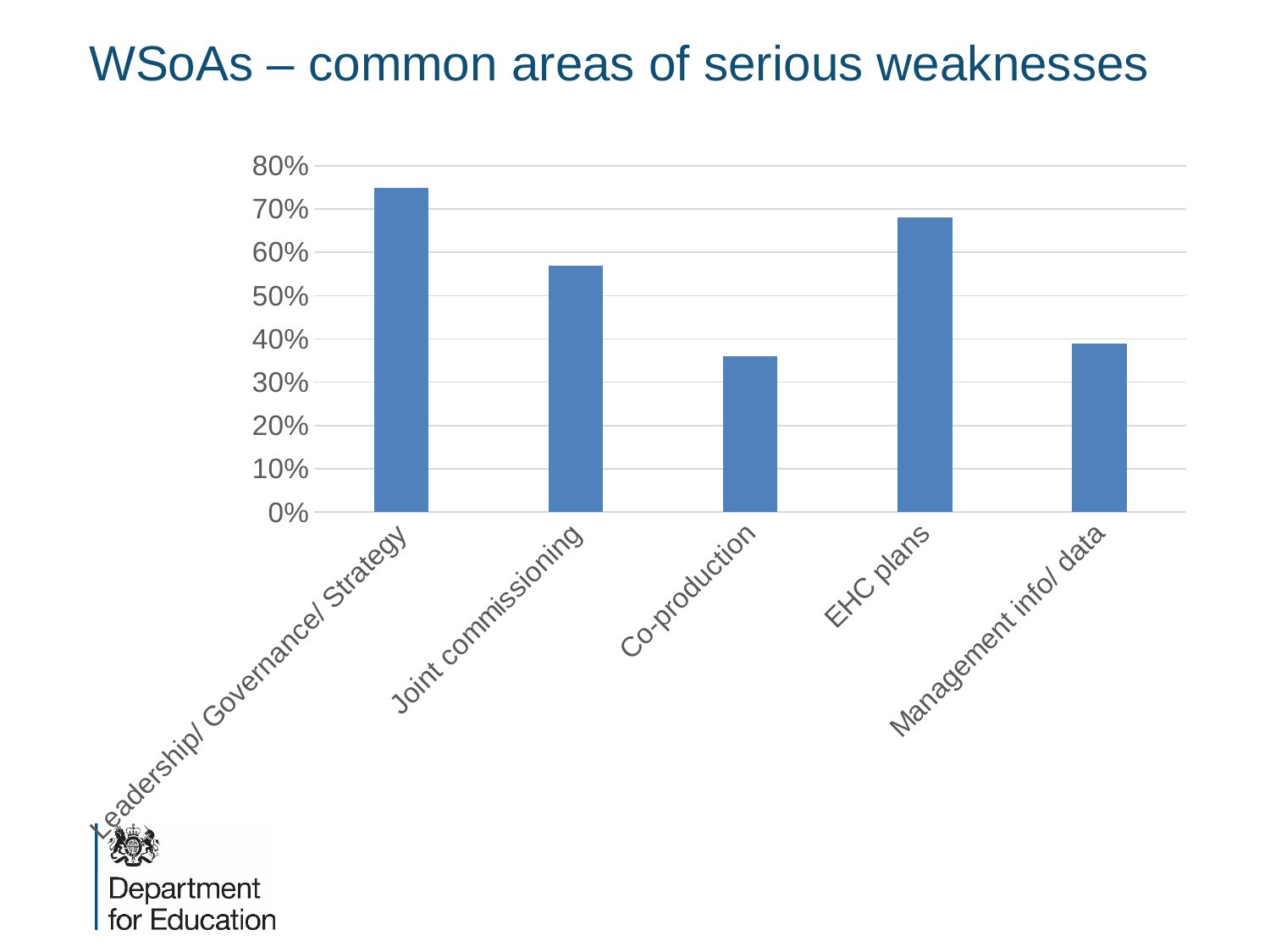
Is the value for Leadership/ Governance/ Strategy greater or less than 70%? greater Which is larger, the value for EHC plans or the value for Joint commissioning? EHC plans What type of chart is shown on the slide? bar chart Is the value for Co-production greater or less than 40%? less Which is larger, the value for Co-production or the value for Leadership/ Governance/ Strategy? Leadership/ Governance/ Strategy Is the value for Management info/ data greater or less than 30%? greater How many categories are shown on the x axis of the chart? 5 What is the title of the slide containing the chart? WSoAs – common areas of serious weaknesses Which category has the highest value in the chart? Leadership/ Governance/ Strategy What is the highest value shown on the y axis of the chart? 80%